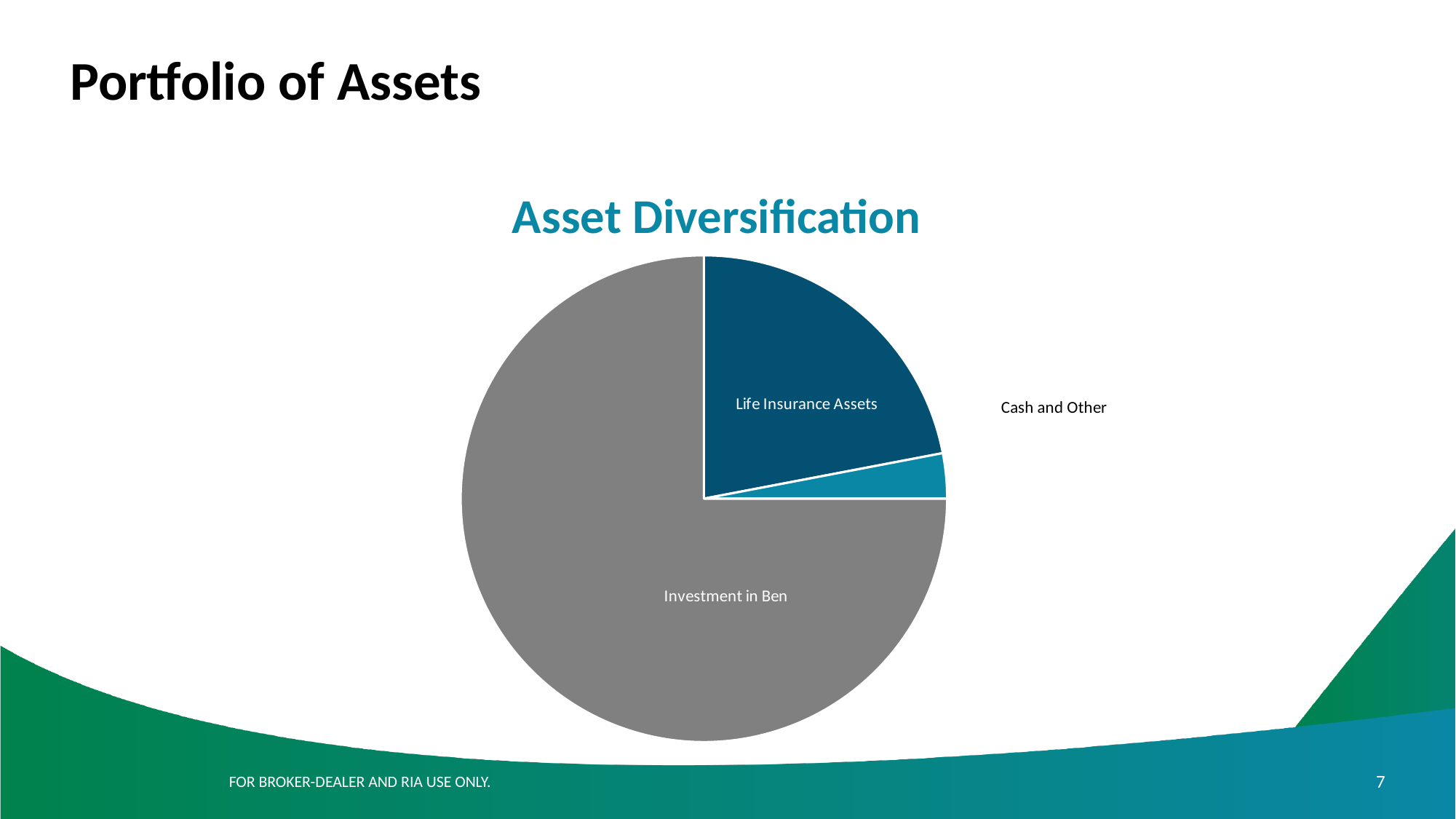
What is the title of the pie chart on the slide? Asset Diversification Which slice is the smallest in the "Asset Diversification" pie chart? Cash and Other Which slice is the largest in the "Asset Diversification" pie chart? Investment in Ben What colour is the "Investment in Ben" slice in the "Asset Diversification" pie chart? gray What kind of chart is shown under the title "Asset Diversification"? pie chart In the "Asset Diversification" pie chart, which is larger: Life Insurance Assets or Cash and Other? Life Insurance Assets In the "Asset Diversification" pie chart, which is larger: Investment in Ben or Life Insurance Assets? Investment in Ben How many slices does the "Asset Diversification" pie chart have? 3